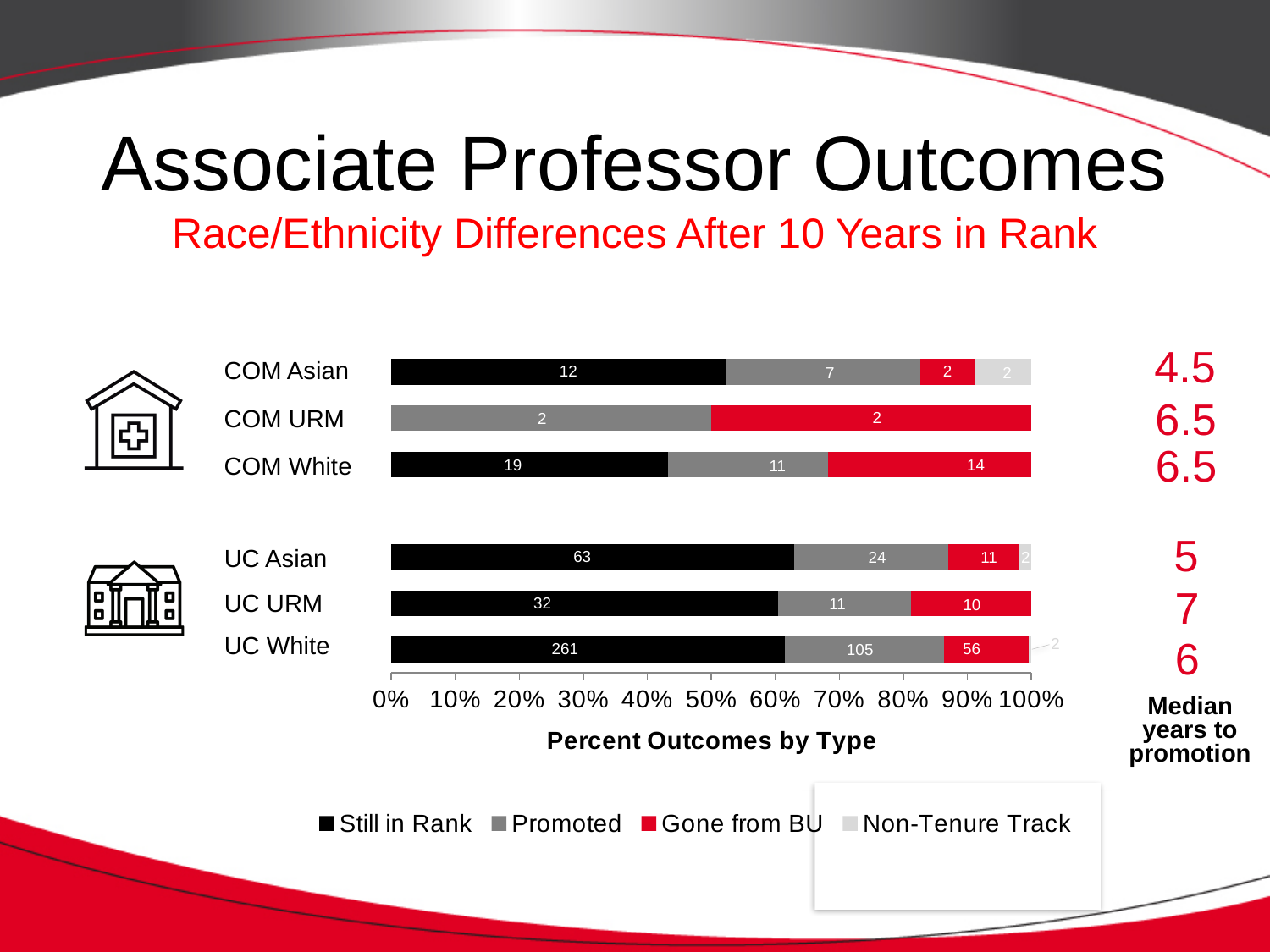
What is the total of all segments in the COM White bar? 44 What is the Still in Rank value for UC White? 261 How many categories (groups) are plotted on the chart? 6 What kind of chart is shown on the slide? stacked bar chart What is the Non-Tenure Track value for COM Asian? 2 What is the title of the horizontal axis? Percent Outcomes by Type How many series does the legend list? 4 What is the difference between the Promoted values for UC White and UC Asian? 81 What is the Gone from BU value for UC URM? 10 What is the total of all segments in the UC Asian bar? 100 What is the Promoted value for COM White? 11 Which is larger, the Still in Rank value for UC Asian or for UC URM? UC Asian